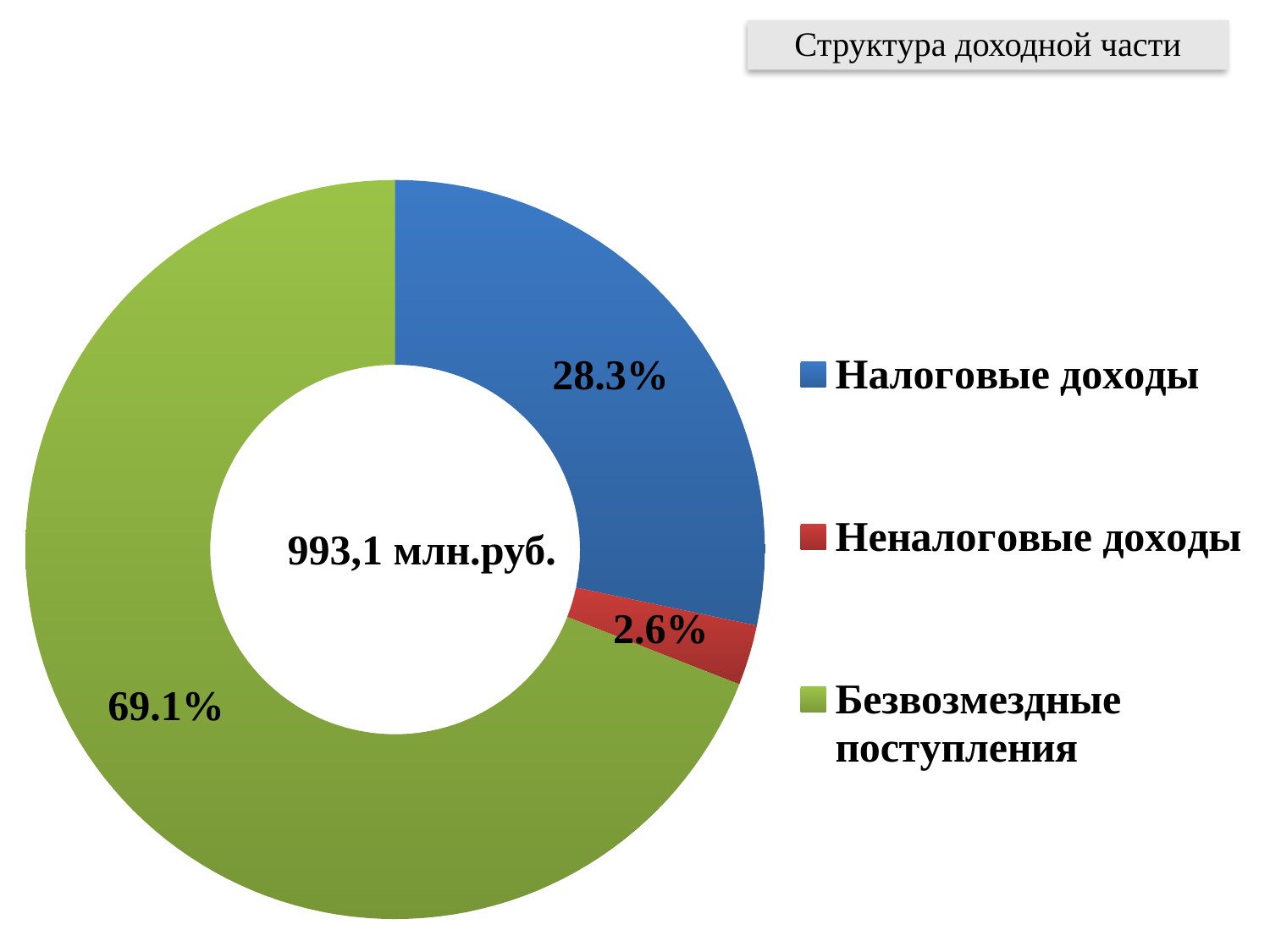
What kind of chart is shown on the slide? Doughnut (pie) chart What share of the chart does Безвозмездные поступления represent? 69.1% What share of the chart does Неналоговые доходы represent? 2.6% How many categories does the chart show? 3 Which is larger: the share for Налоговые доходы or the share for Неналоговые доходы? Налоговые доходы What colour represents Неналоговые доходы in the chart? Red What is the difference in percentage points between the shares of Налоговые доходы and Неналоговые доходы? 25.7 What is the difference in percentage points between the shares of Безвозмездные поступления and Налоговые доходы? 40.8 What share of the chart does Налоговые доходы represent? 28.3% Which category has the smallest share of the chart? Неналоговые доходы Which category has the largest share of the chart? Безвозмездные поступления What total value is printed in the centre of the chart? 993,1 млн.руб.